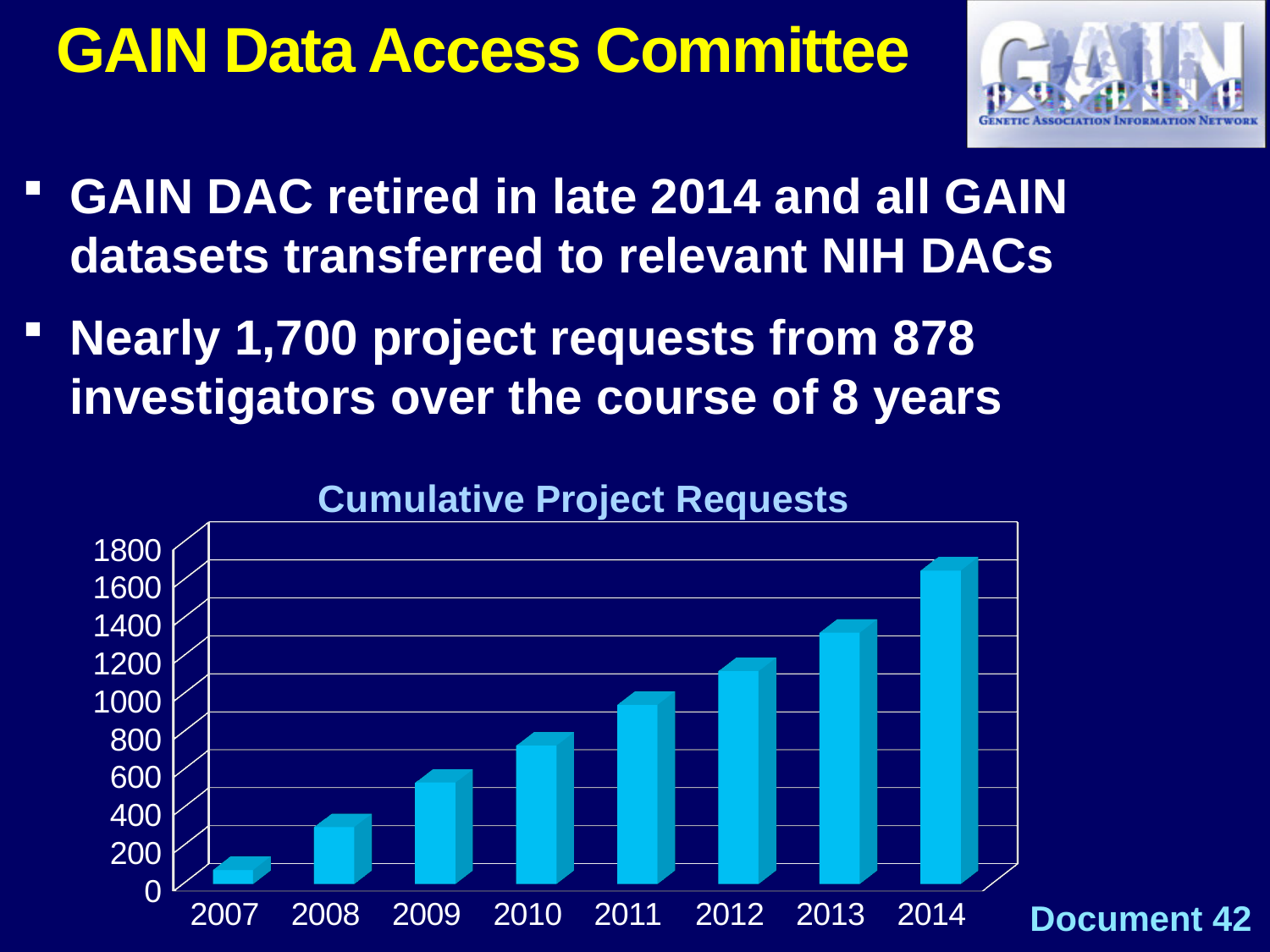
How many years are shown on the x axis of the chart? 8 Is the value for 2012 greater or less than 1000? greater Which year has the highest cumulative project requests? 2014 Is the value for 2008 greater or less than 400? less What is the title of the chart? Cumulative Project Requests What kind of chart is shown on the slide? bar chart Is the value for 2009 greater or less than 400? greater Which year has the lowest cumulative project requests? 2007 Do the cumulative project requests rise or fall from 2007 to 2014? rise Which year has more cumulative project requests, 2010 or 2012? 2012